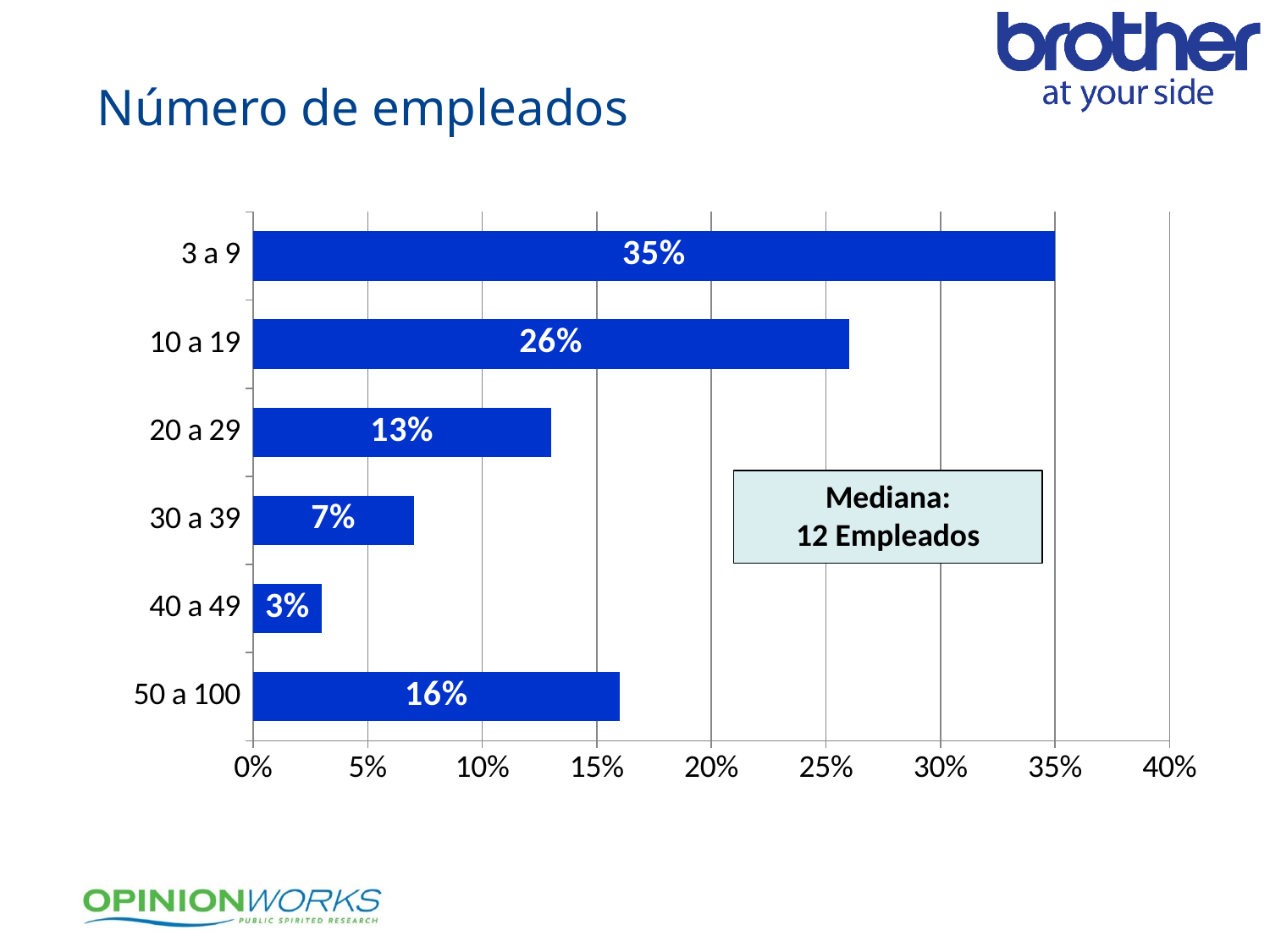
Which is larger, the value for 20 a 29 or the value for 50 a 100? 50 a 100 What median number of employees is stated in the box on the chart? 12 Empleados What is the difference between the values for 50 a 100 and 20 a 29? 3% Which employee-count category has the highest percentage? 3 a 9 What is the value shown for the 50 a 100 category? 16% What is the value shown for the 30 a 39 category? 7% What kind of chart is shown on the slide? Bar chart What percentage of respondents have 3 a 9 employees? 35% Which employee-count category has the lowest percentage? 40 a 49 How many employee-count categories are shown in the chart? 6 What is the difference between the values for 3 a 9 and 10 a 19? 9% Is the value for 10 a 19 greater or less than 25%? greater